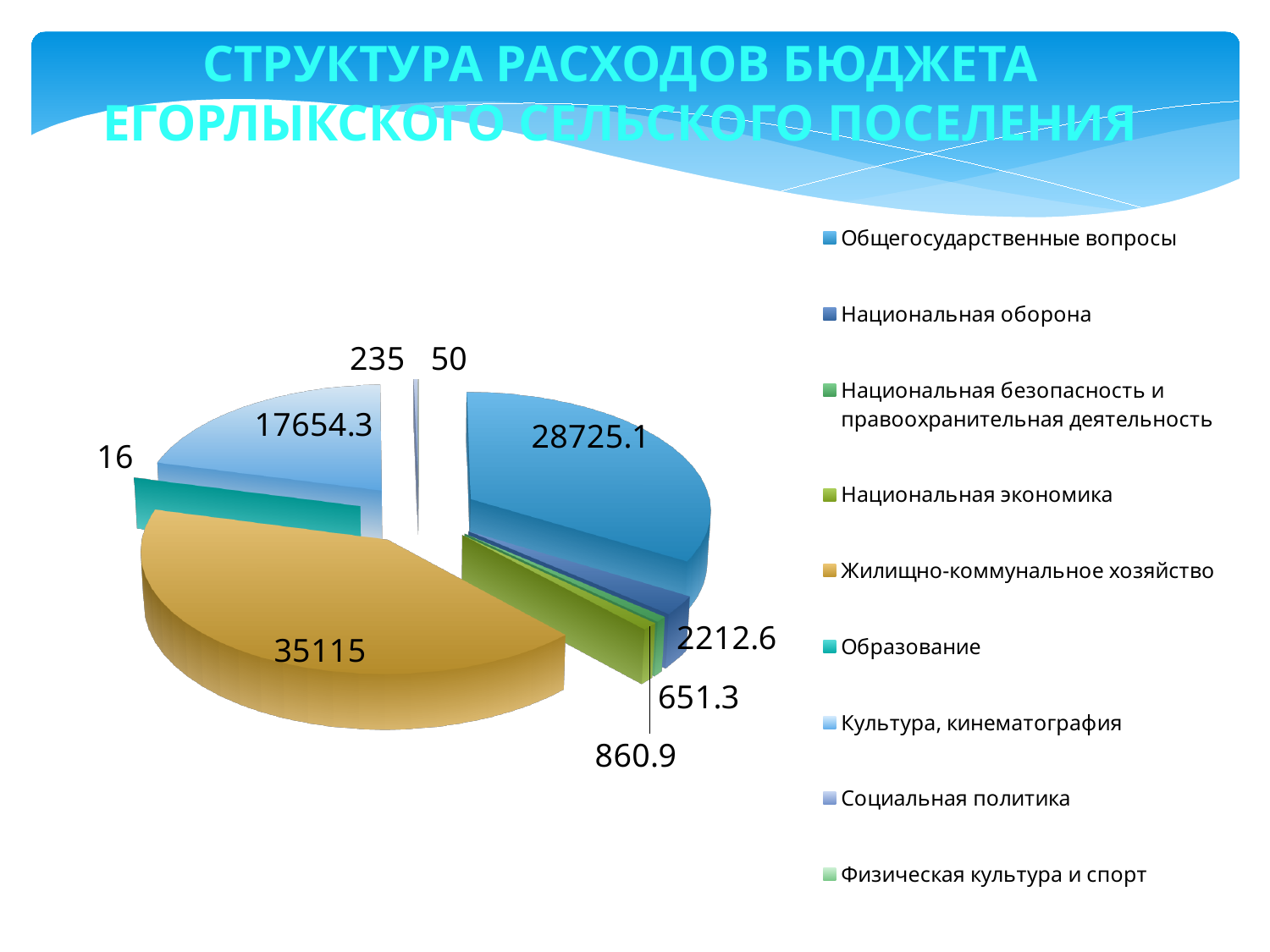
What is the value shown for Культура, кинематография? 17654.3 Which is larger: the value for Общегосударственные вопросы or the value for Культура, кинематография? Общегосударственные вопросы Which category has the smallest value in the pie chart? Образование What is the title of the slide containing the pie chart? СТРУКТУРА РАСХОДОВ БЮДЖЕТА ЕГОРЛЫКСКОГО СЕЛЬСКОГО ПОСЕЛЕНИЯ What is the difference between the values for Жилищно-коммунальное хозяйство and Общегосударственные вопросы? 6389.9 What is the value shown for Жилищно-коммунальное хозяйство? 35115 How many categories does the legend of the pie chart list? 9 What is the value shown for Общегосударственные вопросы? 28725.1 Which category has the largest slice of the pie? Жилищно-коммунальное хозяйство What type of chart is shown on the slide? Pie chart What is the value shown for Образование? 16 What is the difference between the values for Общегосударственные вопросы and Культура, кинематография? 11070.8